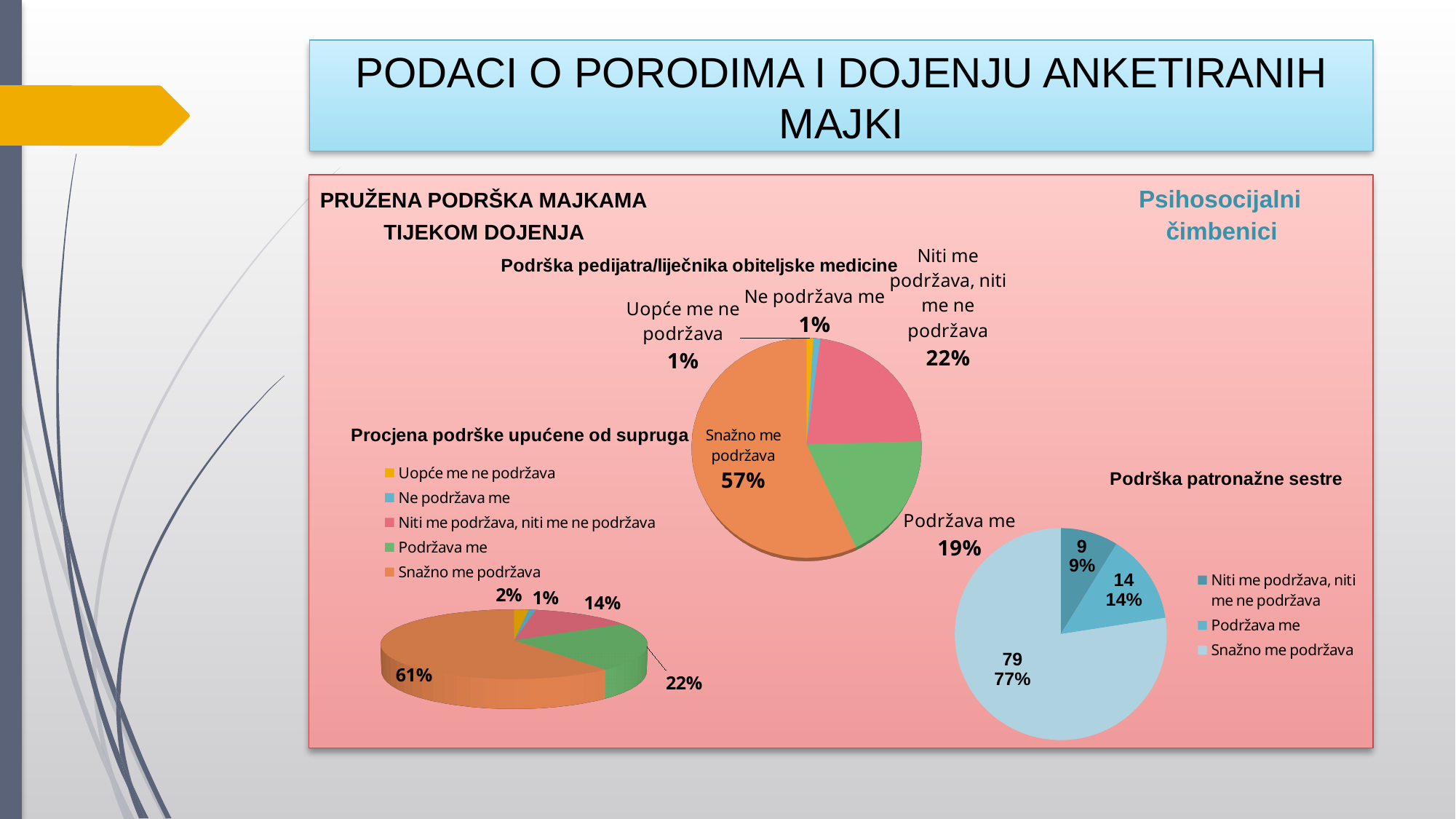
In the chart titled "Procjena podrške upućene od supruga", what percentage is shown for the "Podržava me" slice? 22% In the chart titled "Procjena podrške upućene od supruga", what percentage is shown for the "Snažno me podržava" slice? 61% What type of chart is the chart titled "Podrška patronažne sestre"? Pie chart How many categories does the legend of the chart titled "Podrška patronažne sestre" list? 3 In the chart titled "Podrška pedijatra/liječnika obiteljske medicine", which category has the largest share? Snažno me podržava In the chart titled "Podrška pedijatra/liječnika obiteljske medicine", what percentage is shown for "Snažno me podržava"? 57% In the chart titled "Podrška patronažne sestre", what count is shown for "Snažno me podržava"? 79 In the chart titled "Podrška pedijatra/liječnika obiteljske medicine", what percentage is shown for "Niti me podržava, niti me ne podržava"? 22% In the chart titled "Podrška pedijatra/liječnika obiteljske medicine", what is the difference in percentage points between "Niti me podržava, niti me ne podržava" and "Podržava me"? 3 How many categories does the legend of the chart titled "Procjena podrške upućene od supruga" list? 5 In the chart titled "Podrška patronažne sestre", which category has the smallest share? Niti me podržava, niti me ne podržava In the chart titled "Podrška patronažne sestre", what percentage is shown for "Podržava me"? 14%